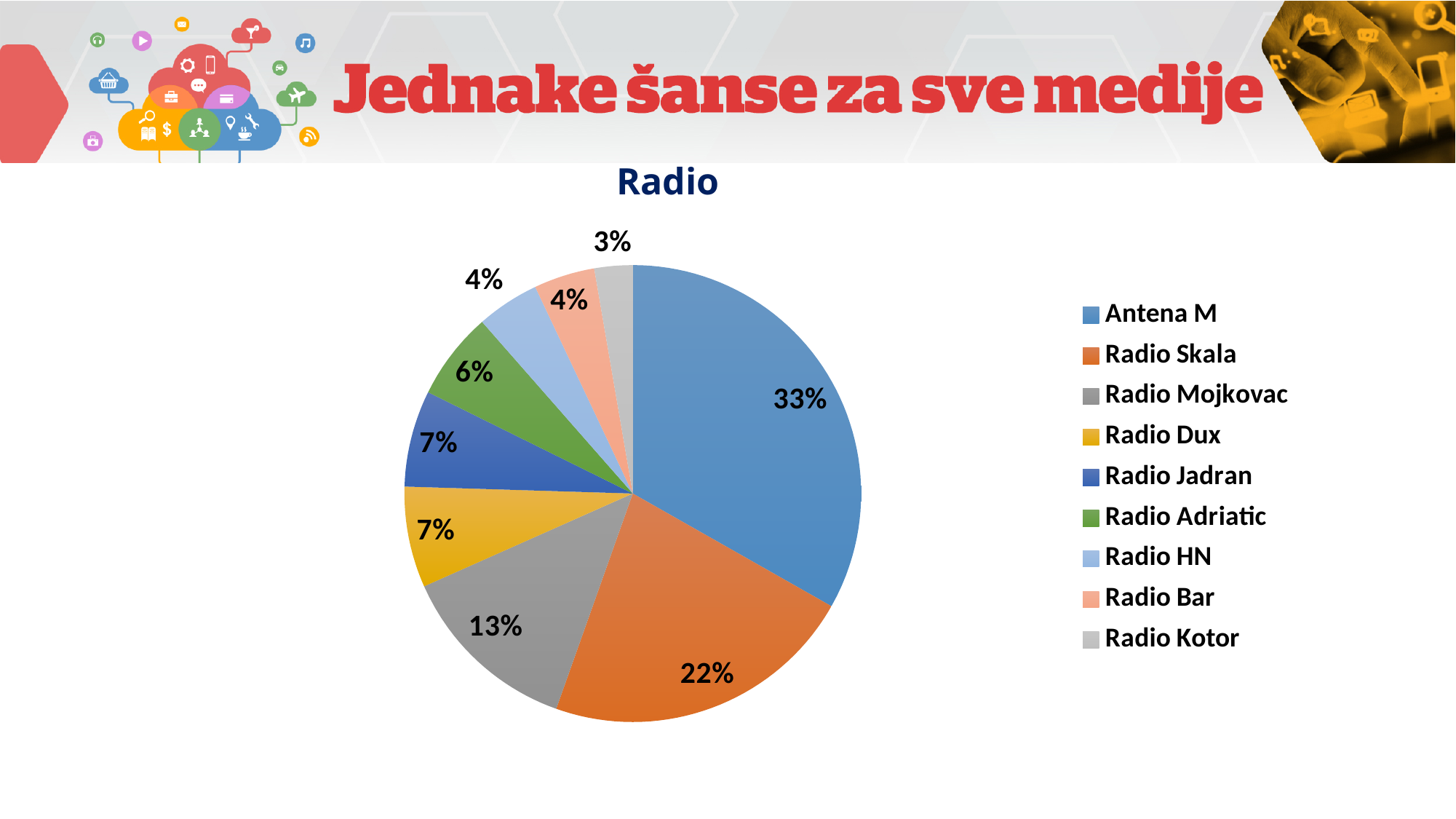
Which radio station has the largest slice of the pie? Antena M What is the value shown for Radio Skala? 22% What is the combined share of Radio HN and Radio Bar? 8% What is the difference between the shares of Antena M and Radio Skala? 11% What is the value shown for Radio Adriatic? 6% What is the title of the chart? Radio What type of chart is shown on the slide? Pie chart How many radio stations are shown in the pie chart? 9 Which radio station has the smallest slice of the pie? Radio Kotor What is the value shown for Radio Mojkovac? 13% Which is larger, the share for Radio Mojkovac or the share for Radio Dux? Radio Mojkovac What share of the pie does Antena M hold? 33%